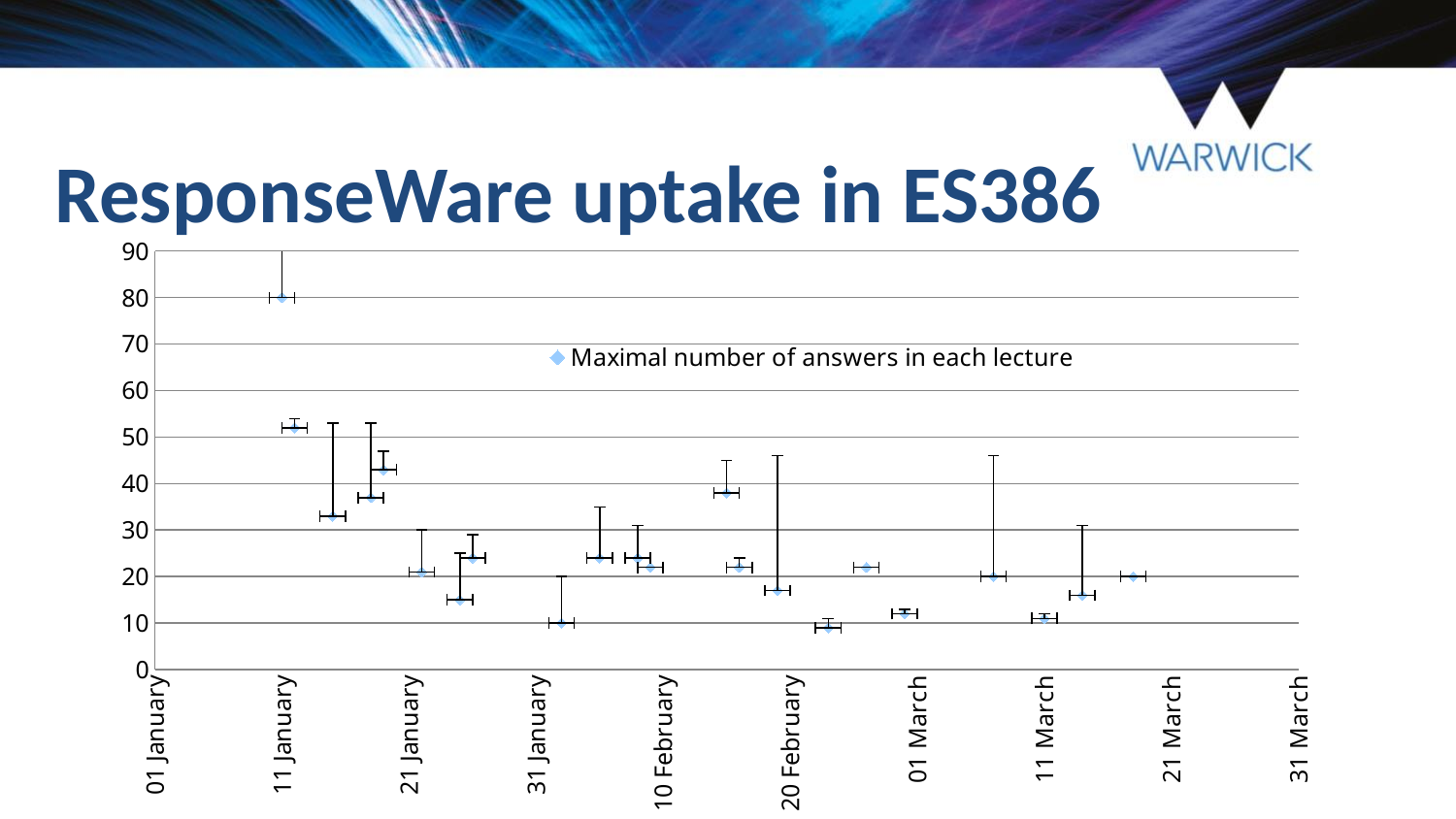
What is the maximum value shown on the y axis? 90 Is the highest plotted value greater or less than 70? greater Do the plotted values generally rise or fall from January to March? fall What kind of chart is shown on the slide? Scatter chart How many plotted points lie above 60 on the y axis? 1 How many series does the chart legend list? 1 Is the highest value plotted after 01 March greater or less than 30? less What is the legend entry for the plotted series? Maximal number of answers in each lecture What is the title of the chart on the slide? ResponseWare uptake in ES386 Is the lowest plotted value greater or less than 20? less Which is larger: the first plotted point in January or the last plotted point in March? The first point in January